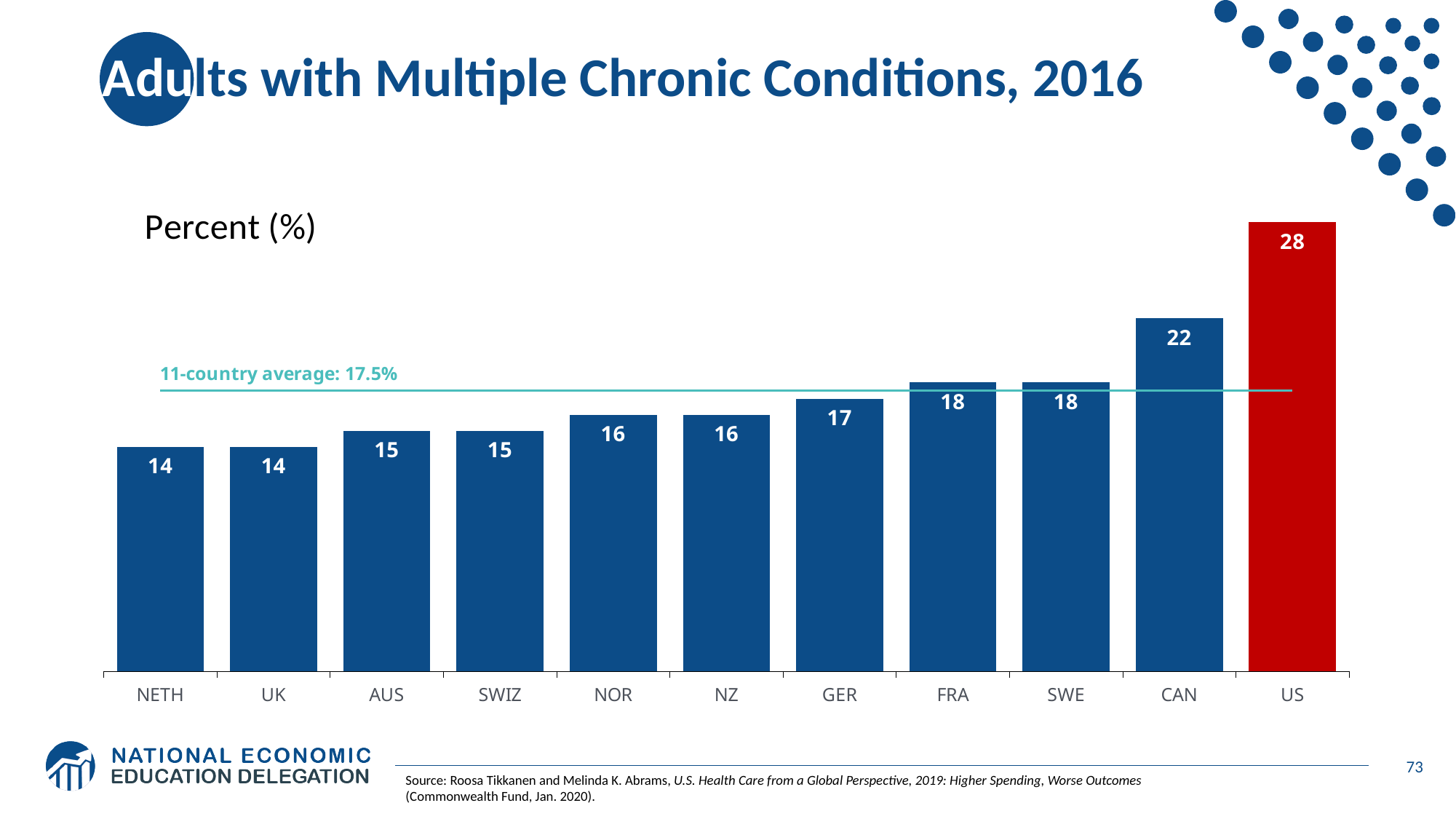
What is the difference between the values for SWE and NETH? 4 Which has a larger value, AUS or CAN? CAN What is the 11-country average shown on the chart? 17.5% Which country has the highest value? US What is the value for the US? 28 How many countries are shown on the chart? 11 What is the value for GER? 17 What kind of chart is shown on the slide? Bar chart Do the values generally rise or fall from NETH to US along the x axis? Rise Which has a larger value, NOR or FRA? FRA What is the value for CAN? 22 What is the difference between the values for the US and CAN? 6